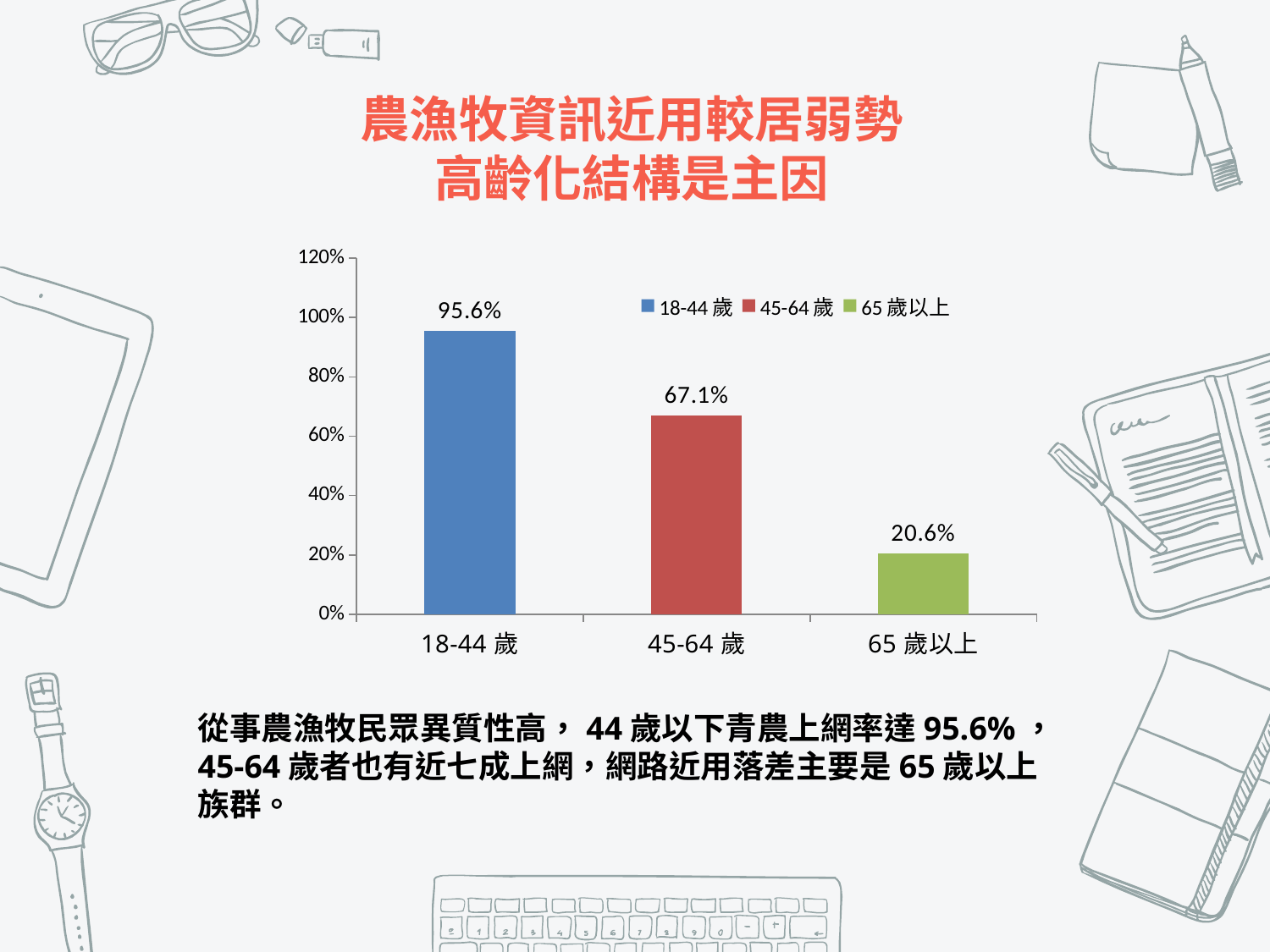
Which is larger, the value for 45-64 歲 or the value for 65 歲以上? 45-64 歲 What is the value for the 45-64 歲 group? 67.1% What is the value for the 18-44 歲 group? 95.6% Which age group has the highest value? 18-44 歲 How many age groups are shown in the chart? 3 What is the value for the 65 歲以上 group? 20.6% What kind of chart is shown on the slide? Bar chart Which age group has the lowest value? 65 歲以上 What is the difference between the values for 18-44 歲 and 65 歲以上? 75.0% Do the values rise or fall from left to right across the age groups? Fall What is the difference between the values for 18-44 歲 and 45-64 歲? 28.5% Is the value for 45-64 歲 greater or less than 60%? greater